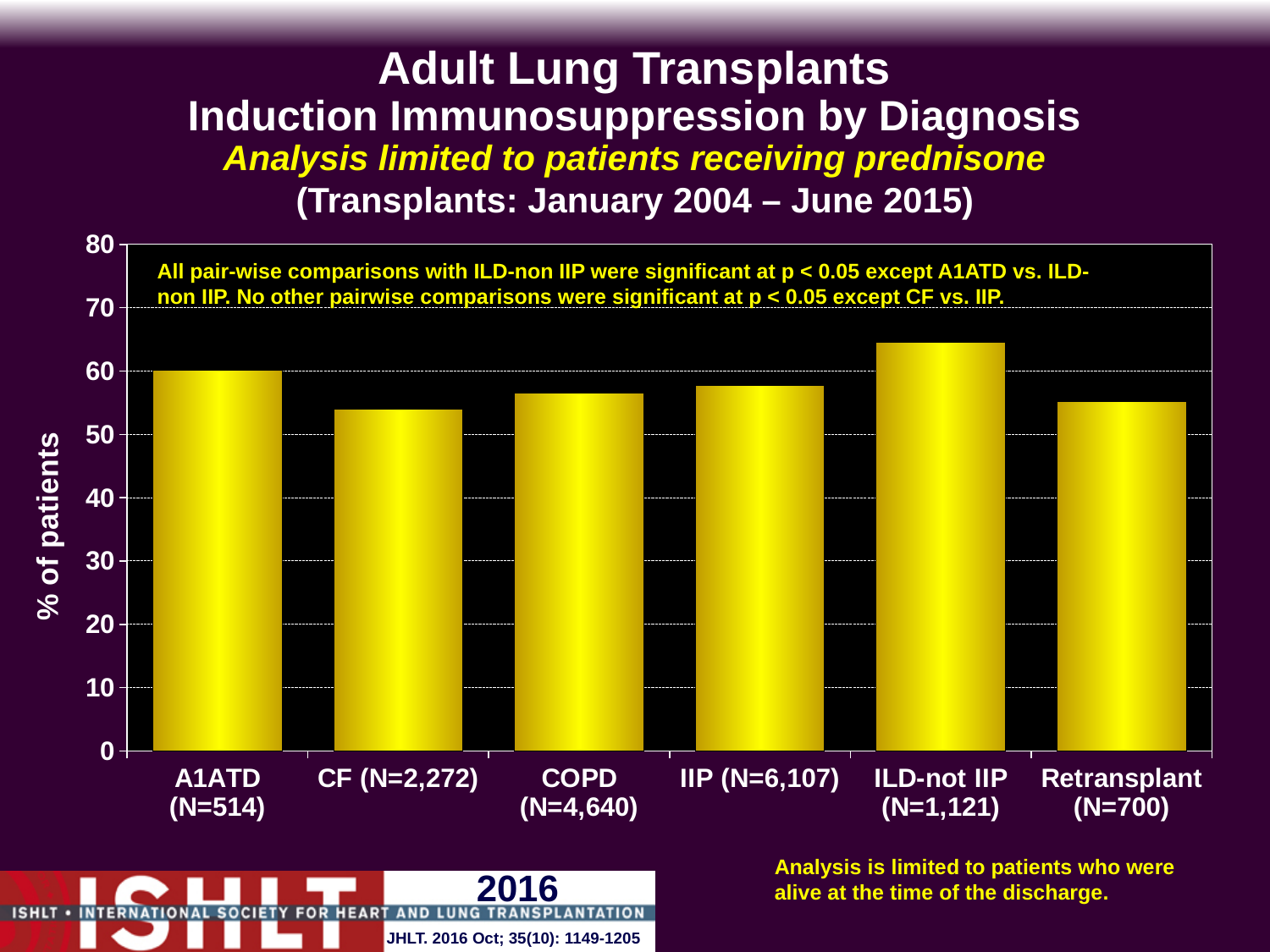
Which diagnosis category has the highest percentage of patients? ILD-not IIP (N=1,121) Is the value for CF greater or less than 60? less What is the label on the vertical axis of the chart? % of patients What kind of chart is shown on the slide? bar chart Is the value for COPD greater or less than 50? greater Is the value for Retransplant greater or less than 60? less Which is larger, the value for A1ATD or the value for CF? A1ATD Which is larger, the value for ILD-not IIP or the value for CF? ILD-not IIP How many diagnosis categories are plotted on the chart? 6